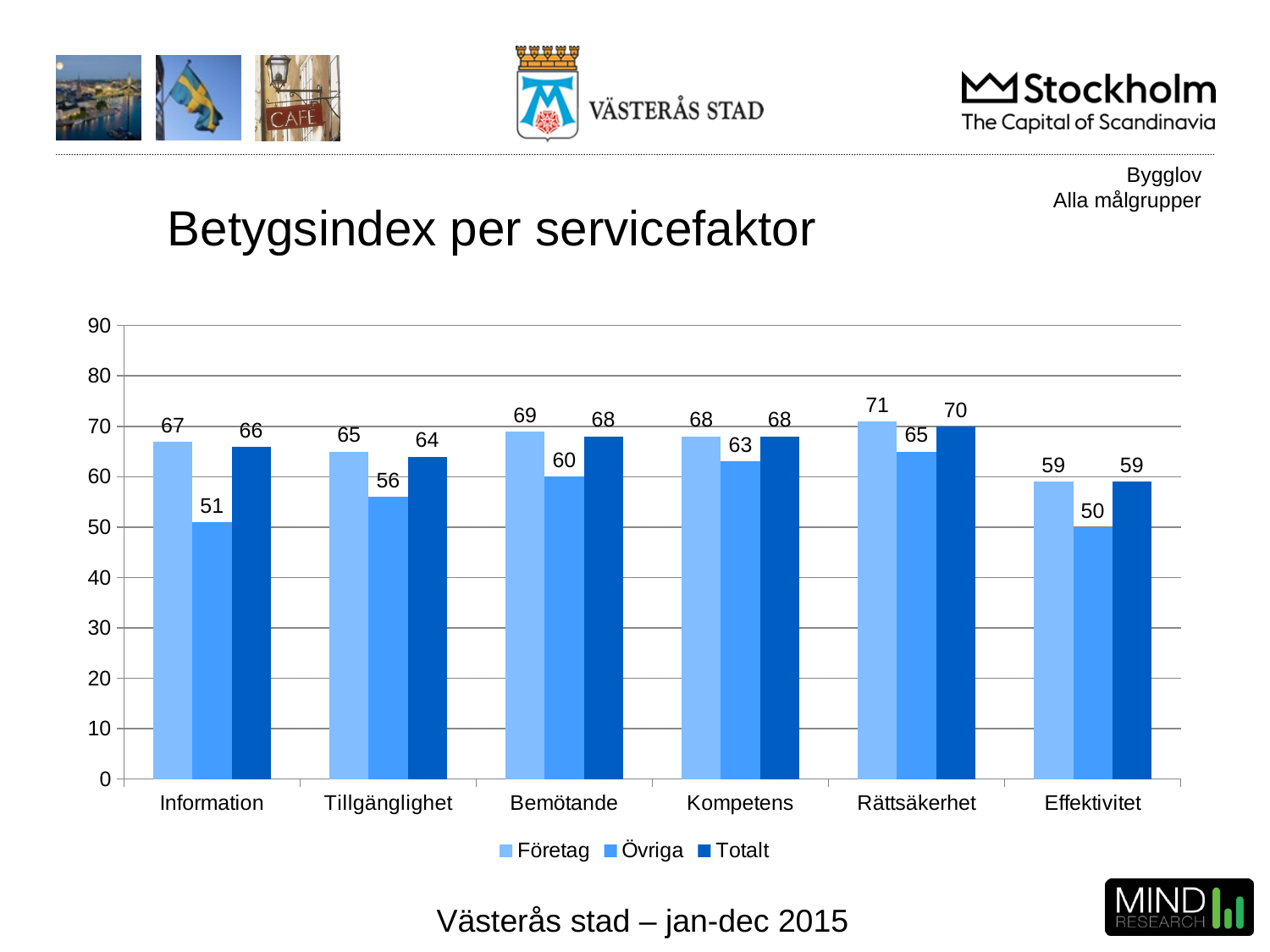
How many series does the legend list? 3 What kind of chart is shown on the slide? bar chart What is the value for Företag in the Information category? 67 What is the value for Övriga in the Tillgänglighet category? 56 What is the title of the chart? Betygsindex per servicefaktor Which category has the lowest value for Övriga? Effektivitet What is the difference between the Företag and Övriga values in the Information category? 16 Which category has the highest value for Företag? Rättsäkerhet Which is larger: the Övriga value for Bemötande or the Övriga value for Kompetens? Kompetens Is the value for Övriga in the Effektivitet category greater or less than 60? less What is the value for Totalt in the Rättsäkerhet category? 70 How many categories are shown on the x axis? 6